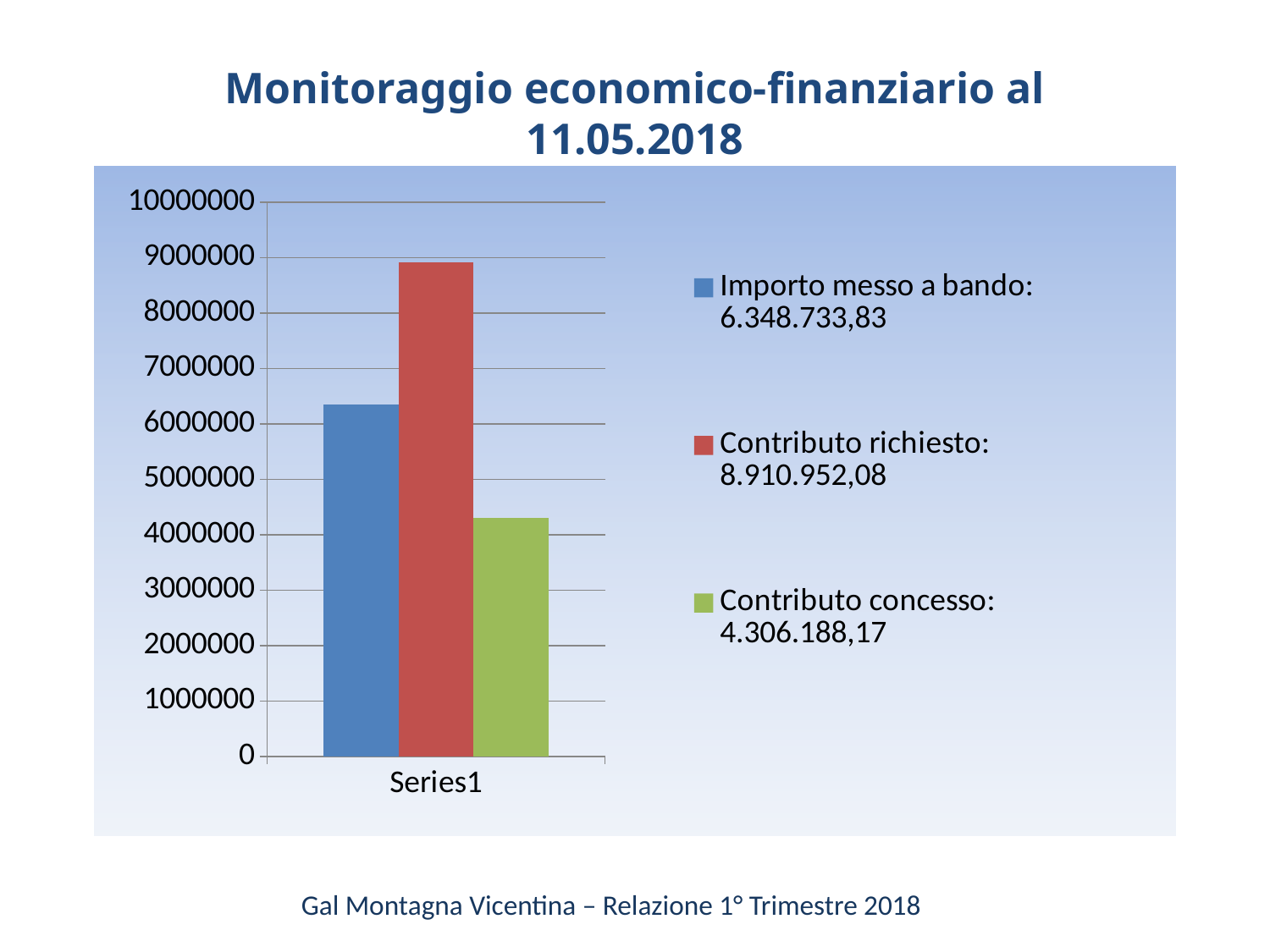
Which is larger, Importo messo a bando or Contributo concesso? Importo messo a bando What is the value for Contributo richiesto? 8.910.952,08 Is the value for Contributo richiesto greater or less than 8000000? greater Which series has the lowest value? Contributo concesso What colour is the bar for Contributo richiesto? Red What kind of chart is shown on the slide? Bar chart Which series has the highest value? Contributo richiesto What is the value for Contributo concesso? 4.306.188,17 What is the difference between Importo messo a bando and Contributo concesso? 2.042.545,66 What is the value for Importo messo a bando? 6.348.733,83 How many series does the legend list? 3 What is the difference between Contributo richiesto and Importo messo a bando? 2.562.218,25